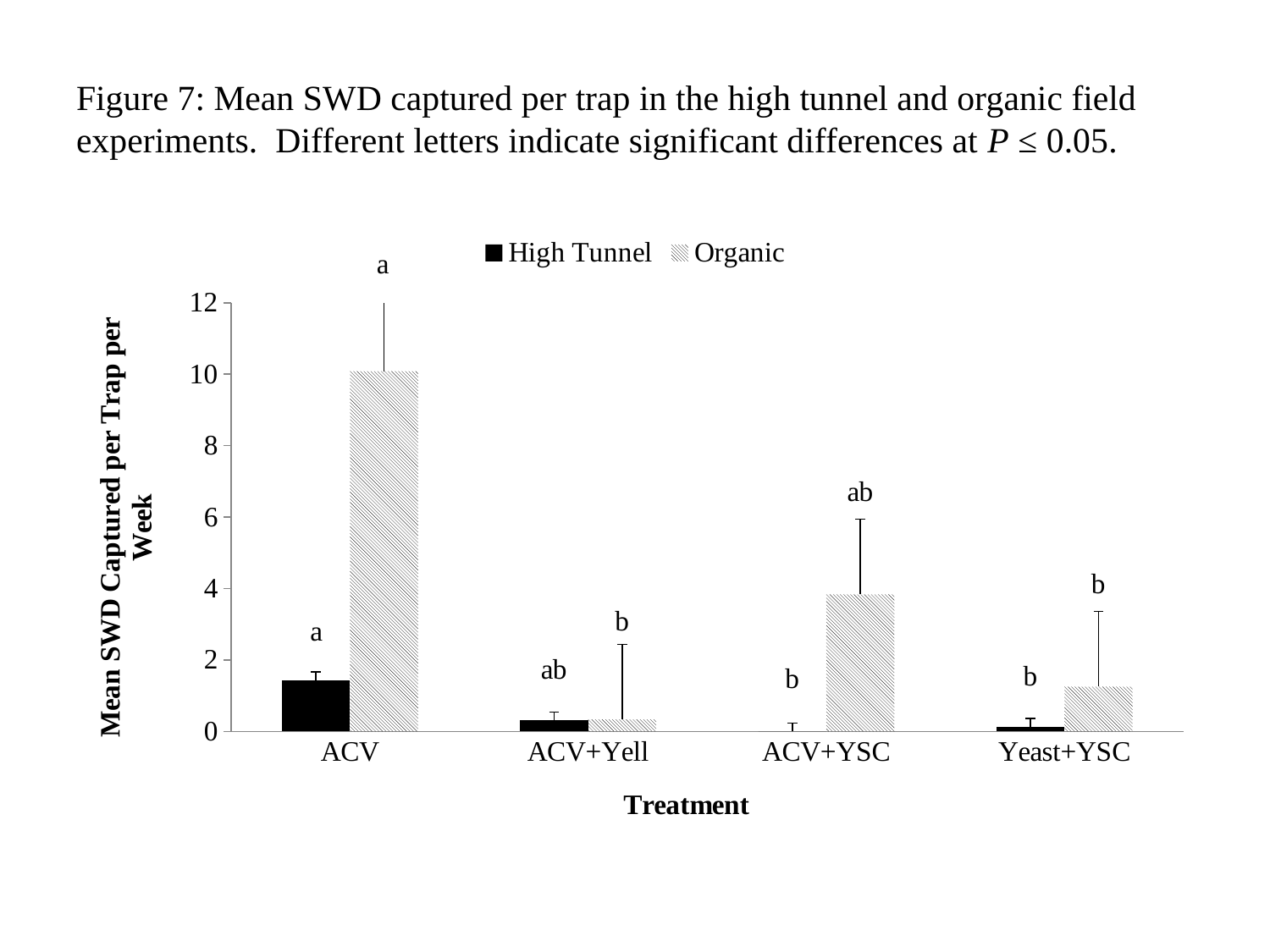
Which treatment has the highest High Tunnel value? ACV Is the High Tunnel value for ACV greater or less than 2? less What kind of chart is shown on the slide? bar chart What is the title of the x axis? Treatment Which treatment has the highest Organic value? ACV What are the two entries in the legend? High Tunnel, Organic How many treatment categories are shown on the x axis? 4 How many series does the legend list? 2 Is the Organic value for ACV greater or less than 8? greater For the ACV treatment, which series has the larger value, High Tunnel or Organic? Organic Which has the larger Organic value, ACV+YSC or Yeast+YSC? ACV+YSC Is the Organic value for ACV+YSC greater or less than 6? less